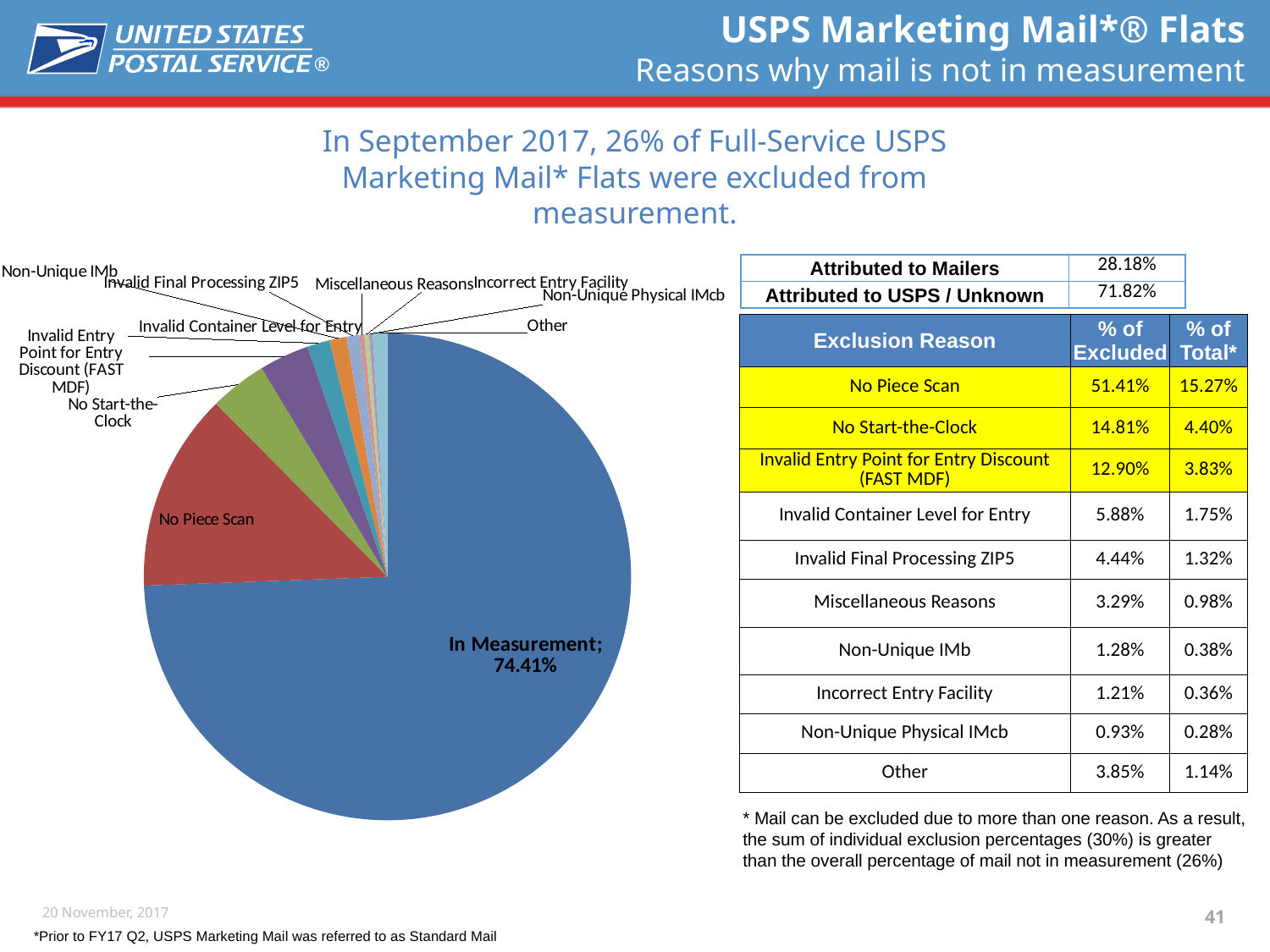
What percentage is shown for the In Measurement slice of the pie chart? 74.41% What colour is the No Piece Scan slice in the pie chart? red What type of chart is shown on the slide? pie chart How many slices does the pie chart have? 11 Which slice of the pie chart is the second largest? No Piece Scan Which slice is larger in the pie chart, No Piece Scan or No Start-the-Clock? No Piece Scan Which slice of the pie chart is the largest? In Measurement Which slice is larger in the pie chart, In Measurement or No Piece Scan? In Measurement Does the In Measurement slice take up more or less than half of the pie chart? more What colour is the In Measurement slice in the pie chart? blue What share of the pie does the In Measurement slice represent? 74.41%